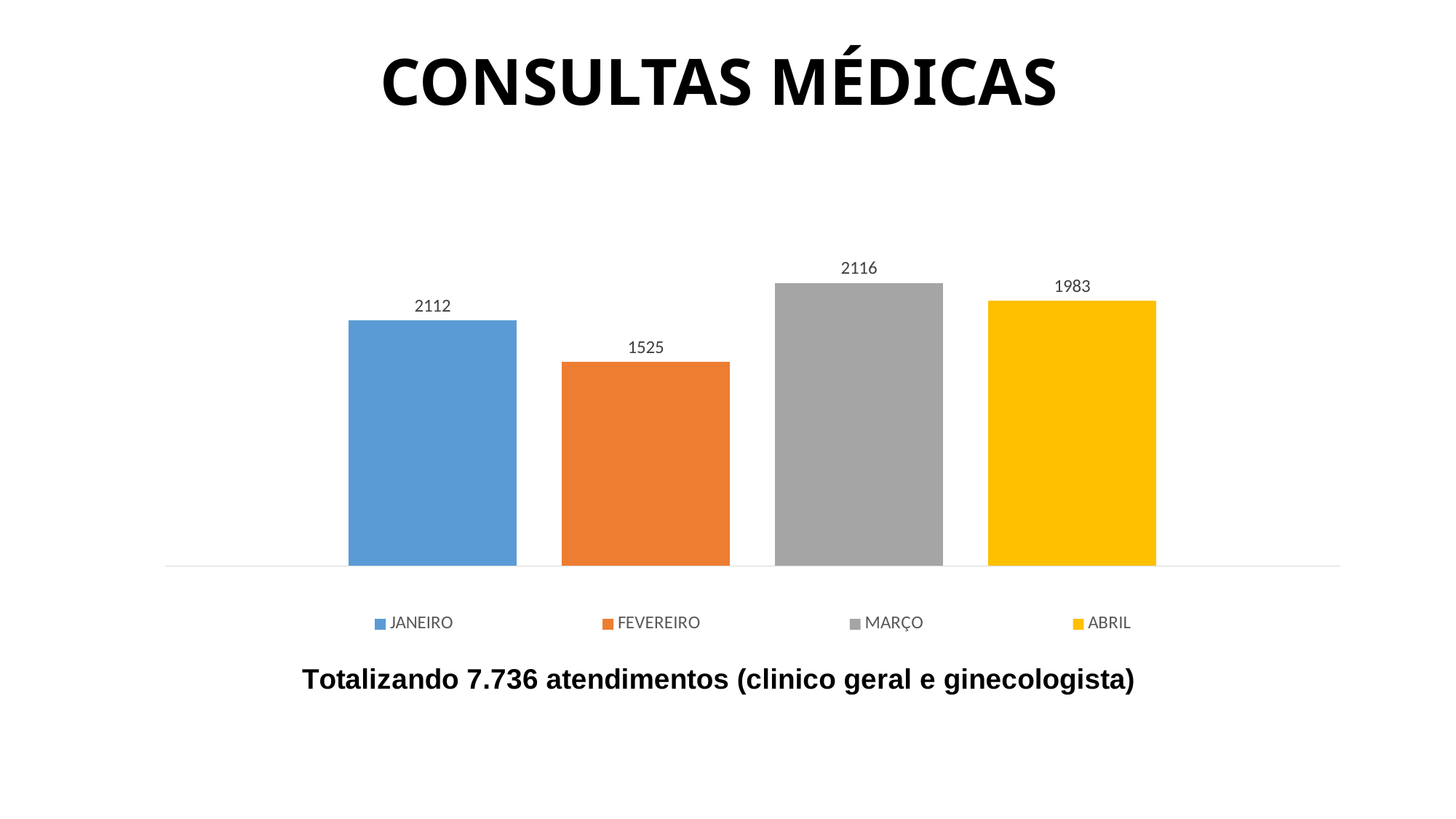
What type of chart is shown on the slide? bar chart Which month has the lowest value? FEVEREIRO What is the value for JANEIRO? 2112 How many bars are shown in the chart? 4 Which month has the highest value? MARÇO What is the difference between the values for MARÇO and FEVEREIRO? 591 What is the value for FEVEREIRO? 1525 What is the title of the slide? CONSULTAS MÉDICAS What is the value for MARÇO? 2116 Which is larger, the value for ABRIL or the value for FEVEREIRO? ABRIL What is the difference between the values for JANEIRO and ABRIL? 129 What is the value for ABRIL? 1983